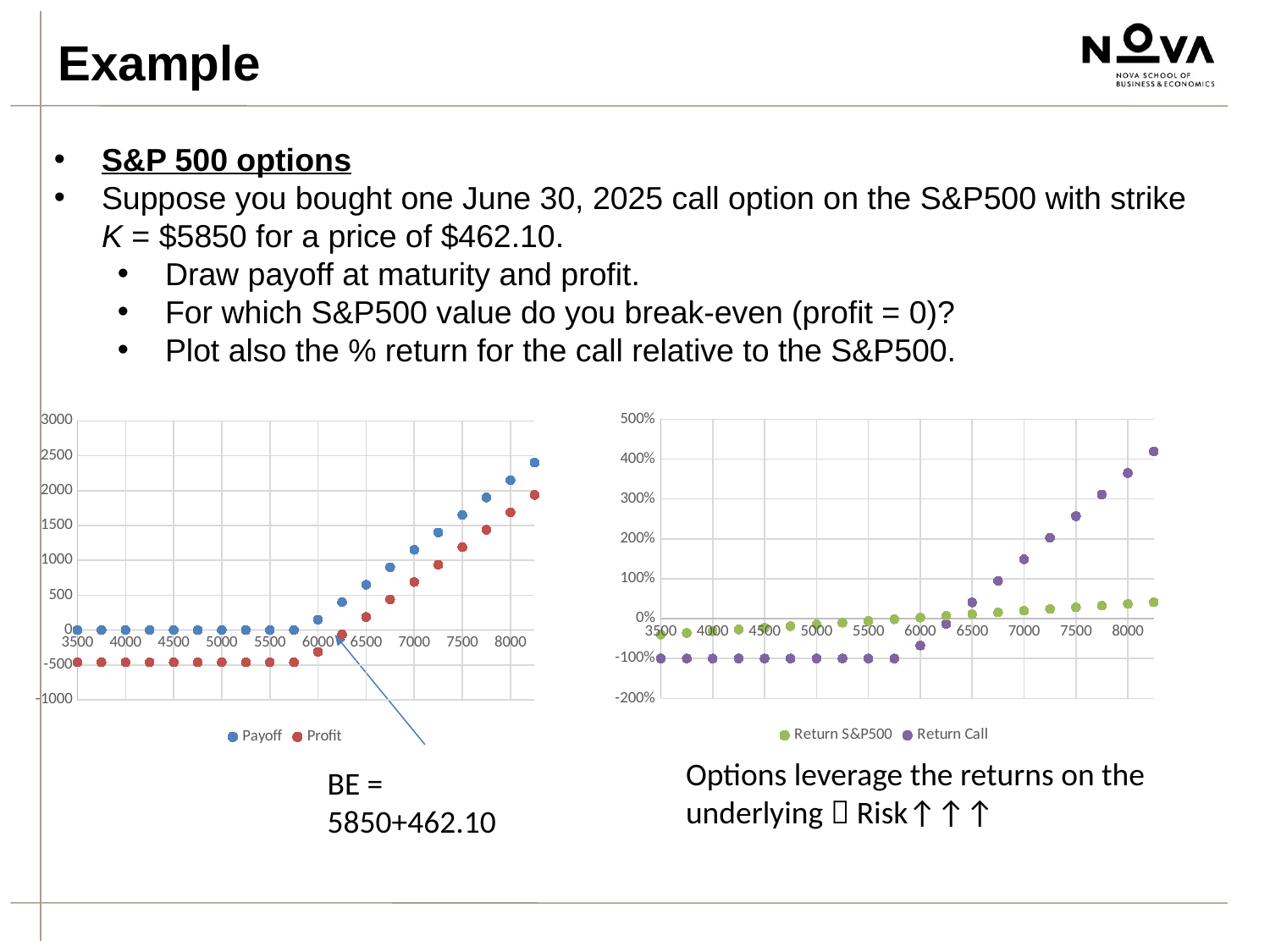
In the right chart, is the Return Call value at 8000 greater or less than 300%? greater What are the two series named in the legend of the right chart? Return S&P500 and Return Call In the left chart, at an S&P500 level of 7000, which series has the larger value, Payoff or Profit? Payoff In the left chart, what is the Payoff value at an S&P500 level of 4000? 0 In the right chart, what is the Return Call value at an S&P500 level of 4000? -100% In the right chart, does the Return Call series rise or fall as the S&P500 level increases from 6000 to 8000? rise In the right chart, at an S&P500 level of 8000, which series has the larger value, Return S&P500 or Return Call? Return Call In the left chart, is the Payoff value at 8000 greater or less than 2000? greater In the left chart, is the Profit value at 8000 greater or less than 1500? greater How many series does the legend of the left chart list? 2 What kind of chart is the left chart with the Payoff and Profit legend? scatter chart